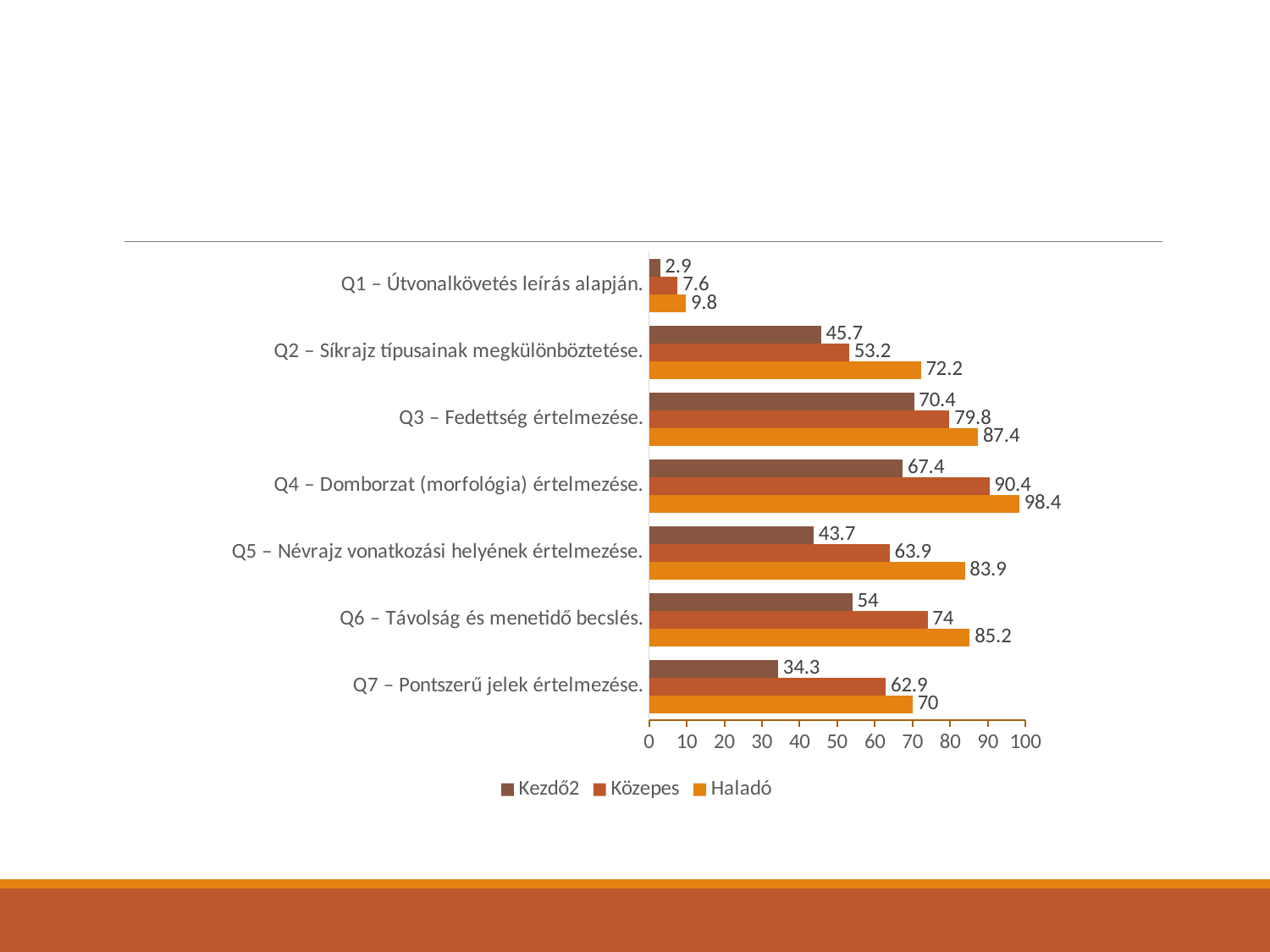
Is the Haladó value for Q5 – Névrajz vonatkozási helyének értelmezése greater or less than 80? greater What is the Haladó value for Q4 – Domborzat (morfológia) értelmezése? 98.4 How many series does the legend list? 3 What is the Közepes value for Q6 – Távolság és menetidő becslés? 74 Which category has the lowest Kezdő2 value? Q1 – Útvonalkövetés leírás alapján. How many categories (questions) are shown on the chart? 7 Which is larger for Q3 – Fedettség értelmezése: the Közepes value or the Kezdő2 value? Közepes What kind of chart is shown on the slide? Bar chart What are the three series names listed in the legend? Kezdő2, Közepes, Haladó What is the difference between the Haladó and Kezdő2 values for Q7 – Pontszerű jelek értelmezése? 35.7 Which category has the highest Haladó value? Q4 – Domborzat (morfológia) értelmezése. What is the Kezdő2 value for Q1 – Útvonalkövetés leírás alapján? 2.9